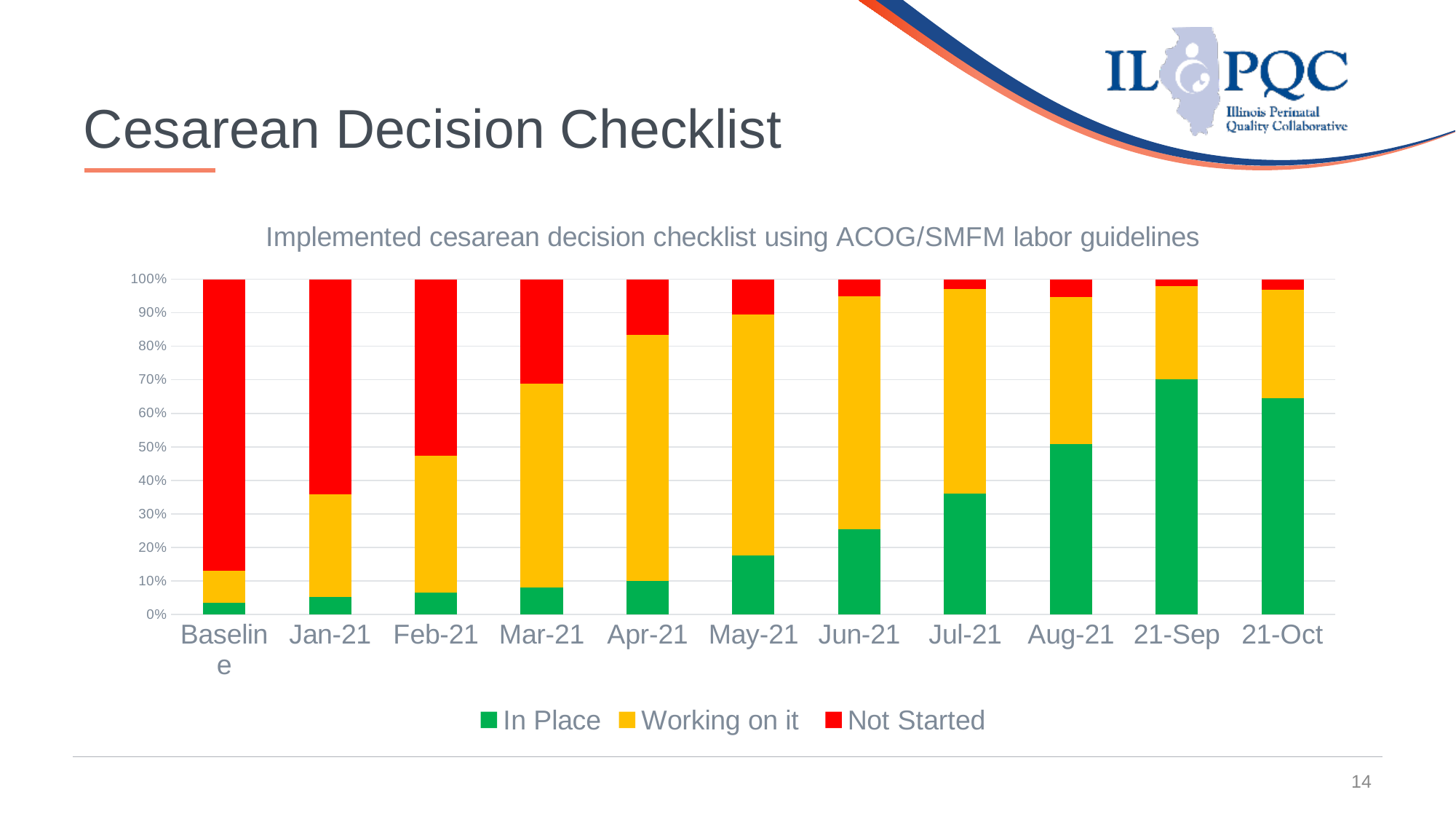
How many categories are shown along the x axis? 11 Which colour represents the 'Not Started' series? Red What kind of chart is shown on the slide? Stacked bar chart How many series does the legend list? 3 Is the 'In Place' value for 21-Sep greater or less than 60%? greater Which category has the largest 'In Place' share? 21-Sep What is the title of the chart? Implemented cesarean decision checklist using ACOG/SMFM labor guidelines Which category has the largest 'Not Started' share? Baseline Is the 'Not Started' value for Baseline greater or less than 80%? greater Does the 'In Place' share rise or fall from Baseline to 21-Sep? rise Is the 'In Place' value for Jul-21 greater or less than 40%? less Which has the larger 'In Place' share, 21-Sep or 21-Oct? 21-Sep